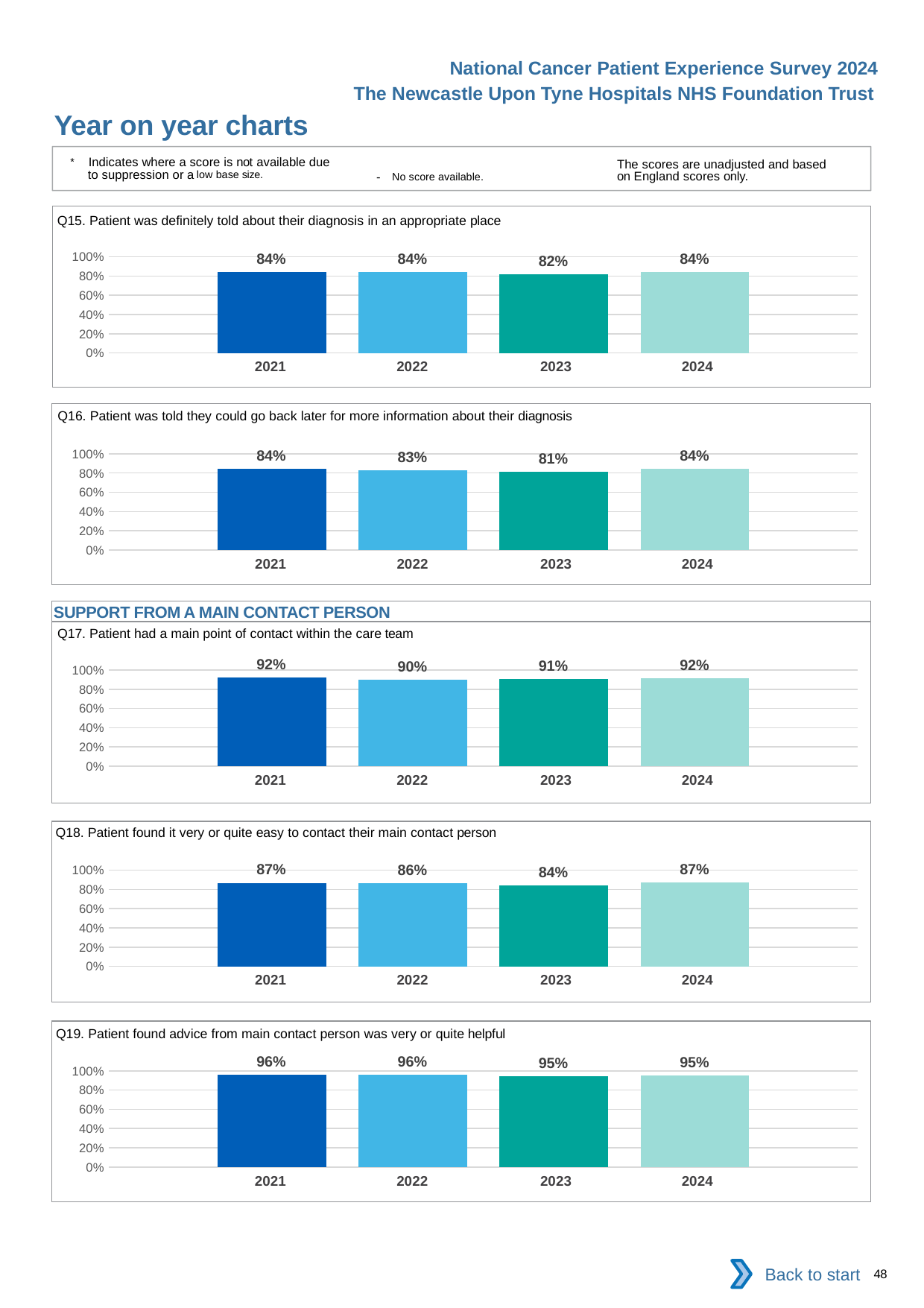
In the Q16 chart, what is the difference between the 2024 value and the 2023 value? 3% In the Q19 chart (patient found advice from main contact person was very or quite helpful), what is the value for 2021? 96% What kind of chart is the Q18 chart? Bar chart In the Q19 chart, is the value for 2024 greater or less than 80%? greater How many years (bars) are shown in the Q15 chart? 4 In the Q16 chart (patient was told they could go back later for more information about their diagnosis), which year has the lowest value? 2023 In the Q15 chart (patient was definitely told about their diagnosis in an appropriate place), what is the value for 2023? 82% In the Q18 chart, what is the difference between the 2021 value and the 2023 value? 3% In the Q17 chart, which is larger, the value for 2021 or the value for 2022? 2021 What is the section heading shown above the Q17 chart? SUPPORT FROM A MAIN CONTACT PERSON In the Q17 chart (patient had a main point of contact within the care team), what is the value for 2022? 90% In the Q18 chart (patient found it very or quite easy to contact their main contact person), which year has the lowest value? 2023